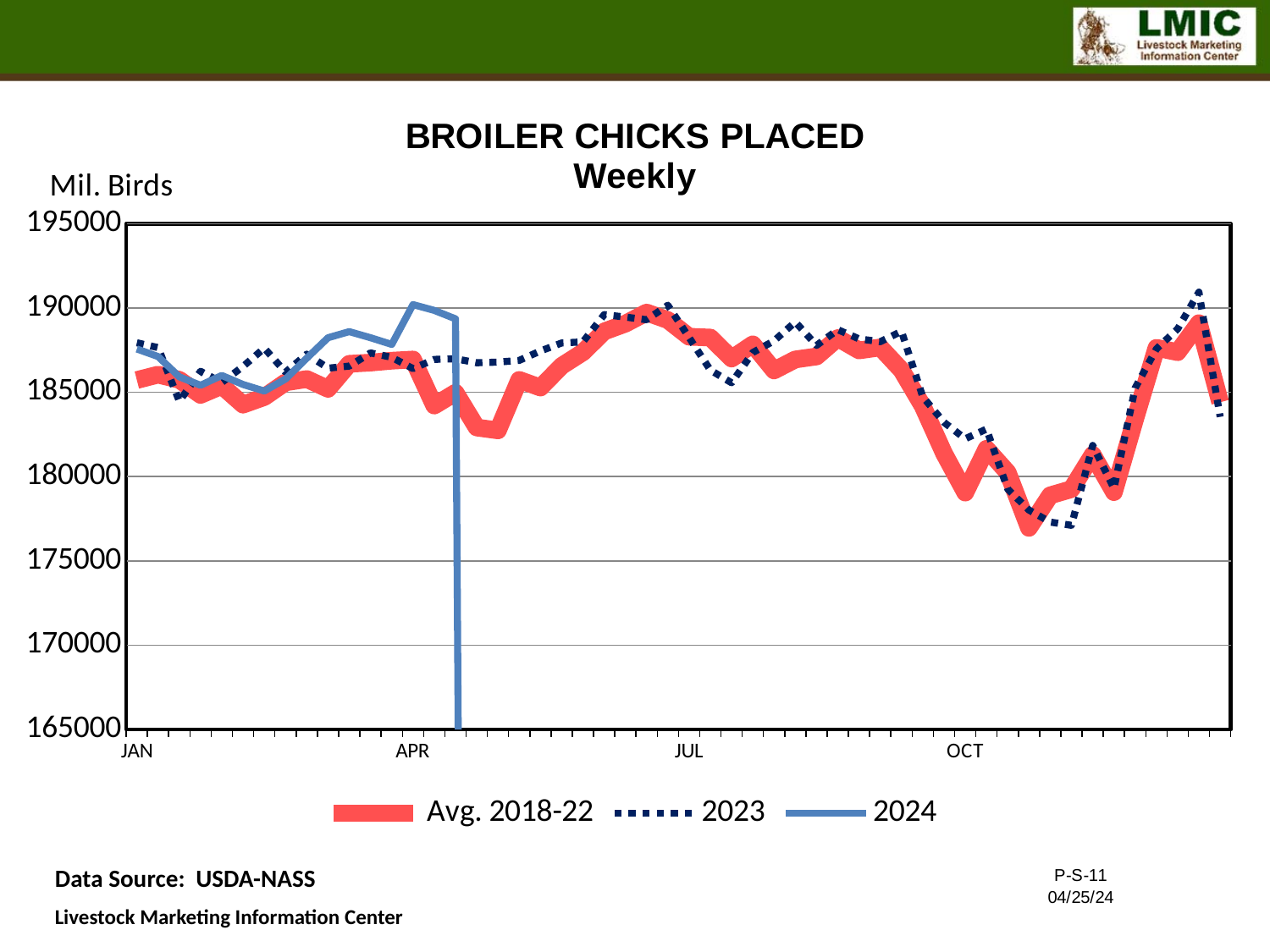
Does the Avg. 2018-22 series rise or fall from early November to mid-December? Rise What is the title of the chart? BROILER CHICKS PLACED Weekly What kind of chart is shown on the slide? Line chart Is the value of the Avg. 2018-22 series in mid-April greater or less than 185000? less Is the lowest value of the Avg. 2018-22 series greater or less than 180000? less How many series does the legend list? 3 At the start of January, which series is higher: 2024 or Avg. 2018-22? 2024 What unit label is shown on the y axis of the chart? Mil. Birds Is the highest value of the 2023 series, reached near the end of the year, greater or less than 190000? greater Does the Avg. 2018-22 series rise or fall between JUL and OCT? Fall Around the start of April, which series is higher: 2024 or Avg. 2018-22? 2024